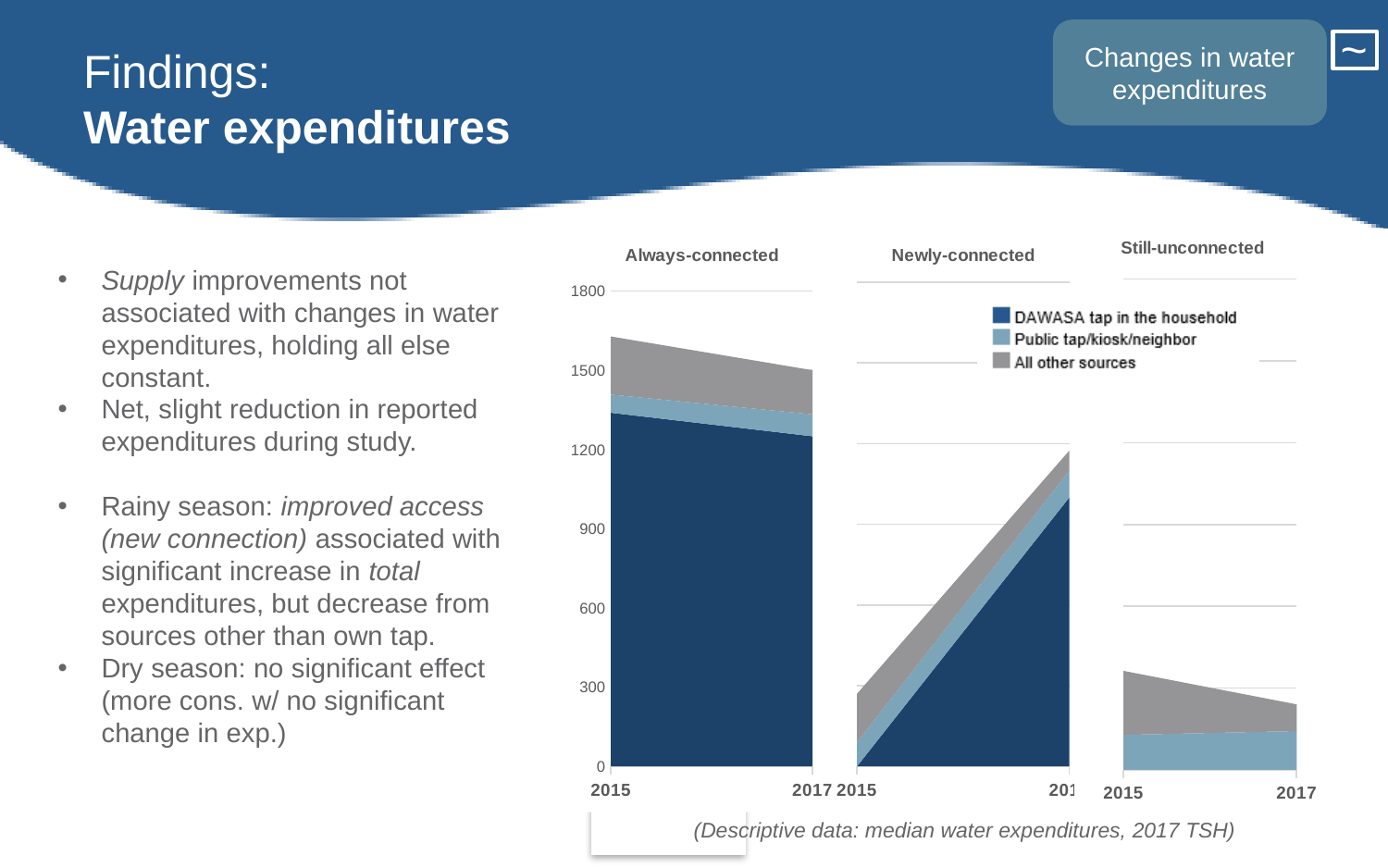
How many series does the legend list? 3 In the Newly-connected panel, does the total expenditure rise or fall from 2015 to 2017? rise In the Newly-connected panel, is the total value in 2015 greater or less than 600? less Which series is shown in grey in the legend? All other sources How many years are shown on the x axis of each panel? 2 Which panel has the larger total value in 2017, Newly-connected or Still-unconnected? Newly-connected In the Still-unconnected panel, is the total value in 2017 greater or less than 300? less What kind of chart is used for the Always-connected panel? Stacked area chart In the Always-connected panel, is the total value in 2015 greater or less than 1500? greater In the Always-connected panel, does the total expenditure rise or fall from 2015 to 2017? fall Which series is shown in dark blue in the legend? DAWASA tap in the household